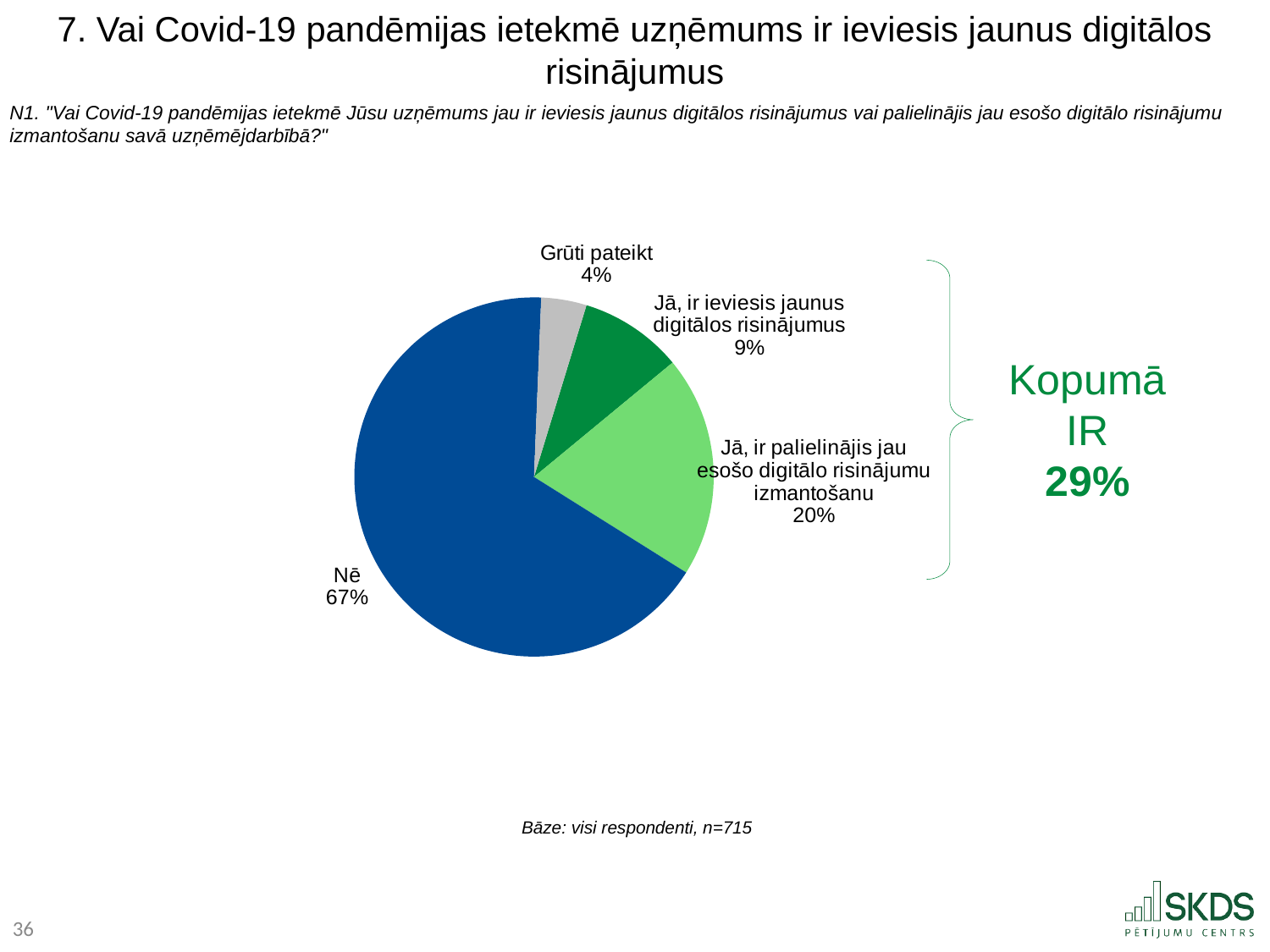
Which answer has the smallest slice of the pie? Grūti pateikt What kind of chart is shown on the slide? pie chart What combined share is shown for the two "Jā" answers ("Kopumā IR")? 29% What is the difference in percentage points between "Nē" and "Jā, ir palielinājis jau esošo digitālo risinājumu izmantošanu"? 47 What share of respondents answered "Jā, ir ieviesis jaunus digitālos risinājumus"? 9% How many slices does the pie chart have? 4 Which answer has the largest slice of the pie? Nē What share of respondents answered "Nē"? 67% What share of respondents answered "Grūti pateikt"? 4% Which is larger: the share for "Jā, ir ieviesis jaunus digitālos risinājumus" or for "Grūti pateikt"? Jā, ir ieviesis jaunus digitālos risinājumus What share of respondents answered "Jā, ir palielinājis jau esošo digitālo risinājumu izmantošanu"? 20% What is the base (n) of respondents stated below the chart? n=715